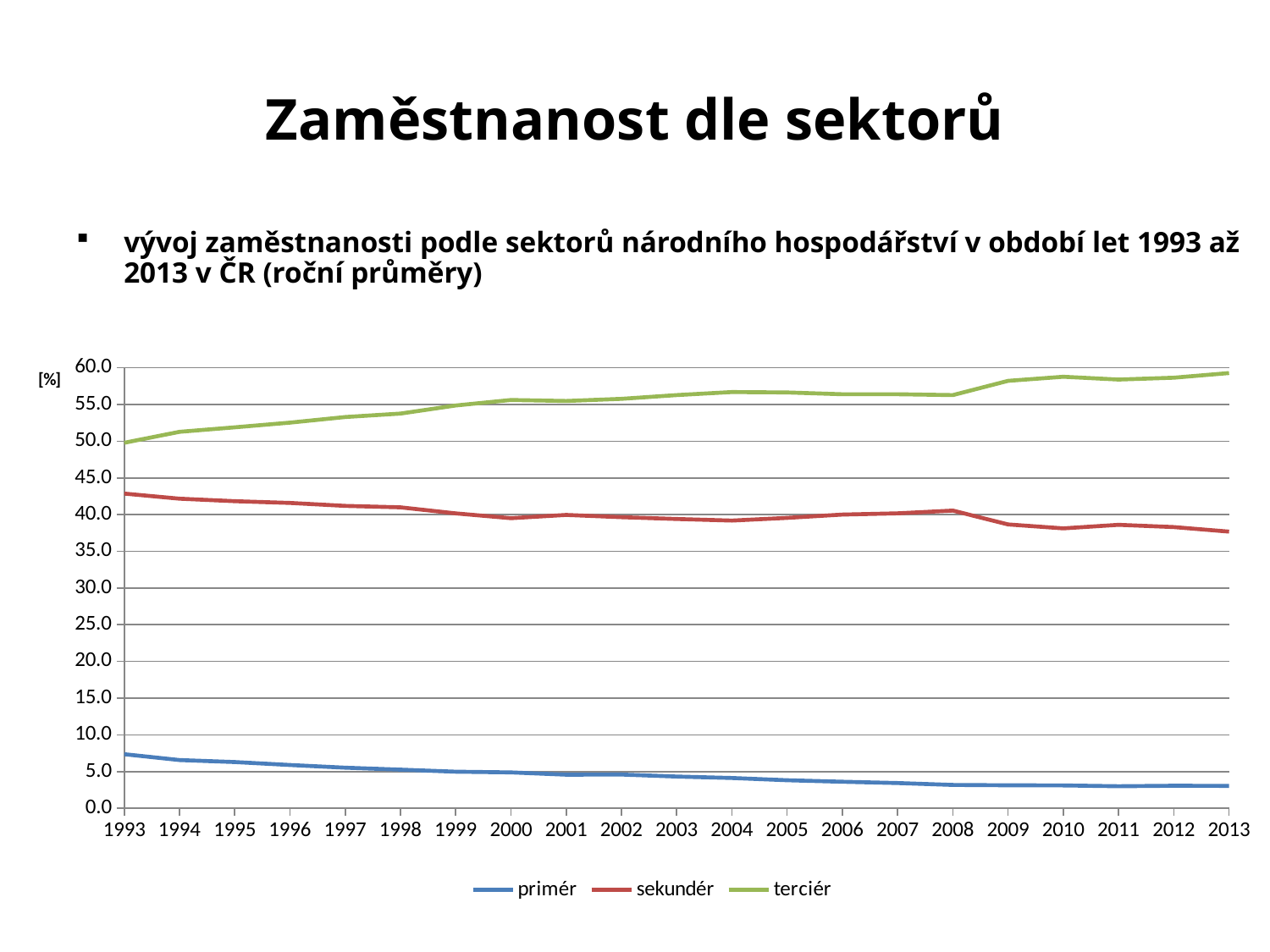
What unit is shown on the y axis label? [%] Which series has the highest values throughout the period? terciér Is the value for primér in 1993 greater or less than 5.0? greater Which series has the lowest values throughout the period? primér In 2013, which is larger: the value for terciér or the value for sekundér? terciér Is the value for terciér in 2013 greater or less than 55.0? greater Is the value for sekundér in 2013 greater or less than 40.0? less What kind of chart is shown on the slide? line chart Does the terciér series rise or fall from 1993 to 2013? rise How many series does the legend list? 3 How many years are plotted along the x axis? 21 Does the primér series rise or fall from 1993 to 2013? fall